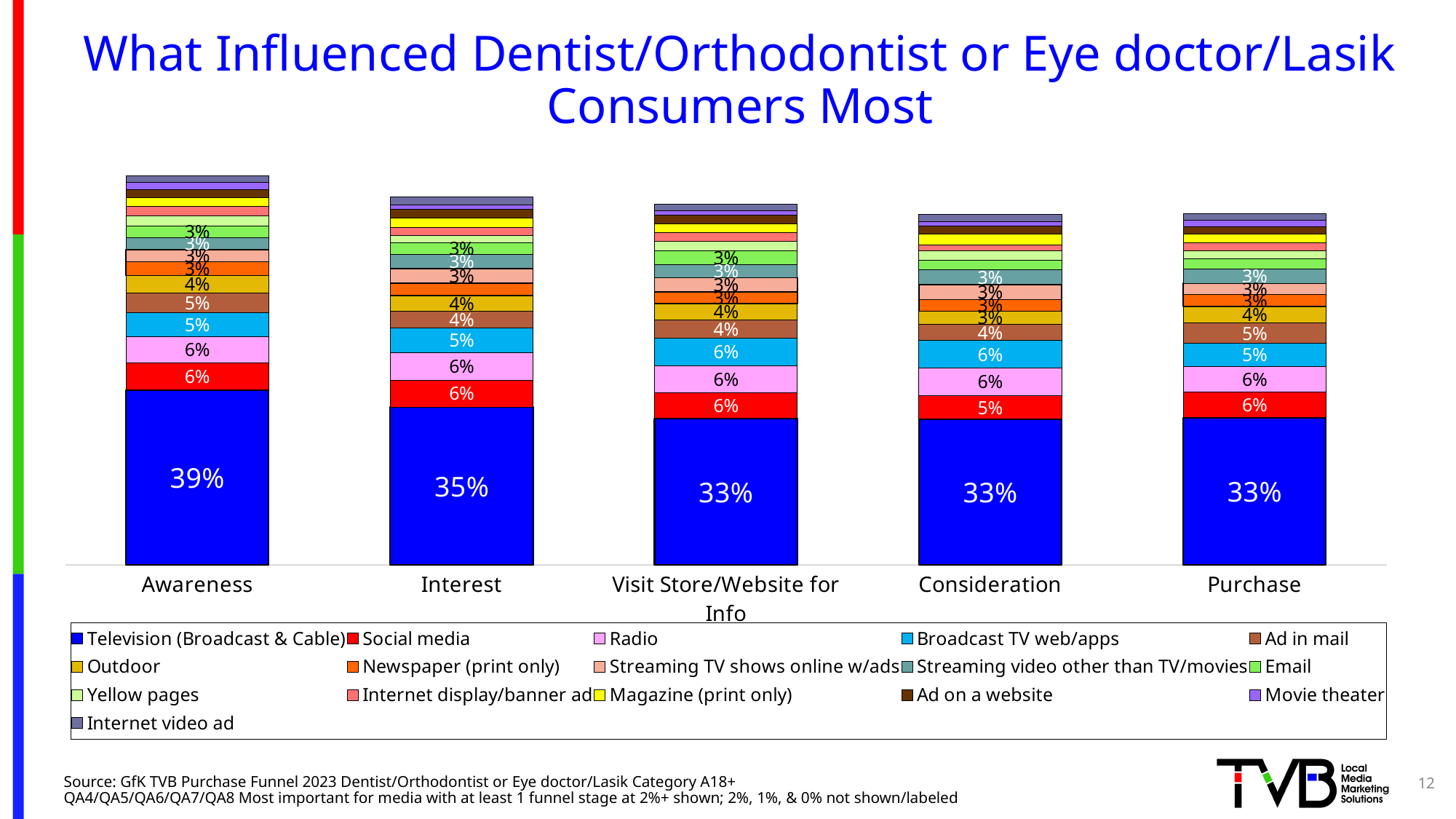
What is the value for Ad in mail in the Awareness stage? 5% Which stage has the larger Television (Broadcast & Cable) value, Awareness or Interest? Awareness What is the value for Television (Broadcast & Cable) in the Interest stage? 35% How many funnel stages are shown on the x axis? 5 What is the value for Social media in the Consideration stage? 5% What is the value for Broadcast TV web/apps in the Visit Store/Website for Info stage? 6% What kind of chart is shown on the slide? Stacked bar chart Does the Television (Broadcast & Cable) value rise or fall from Awareness to Visit Store/Website for Info? Fall What is the value for Television (Broadcast & Cable) in the Awareness stage? 39% How many series does the legend list? 16 In which funnel stage is the Television (Broadcast & Cable) value highest? Awareness What is the difference between the Television (Broadcast & Cable) values for Awareness and Purchase? 6 percentage points